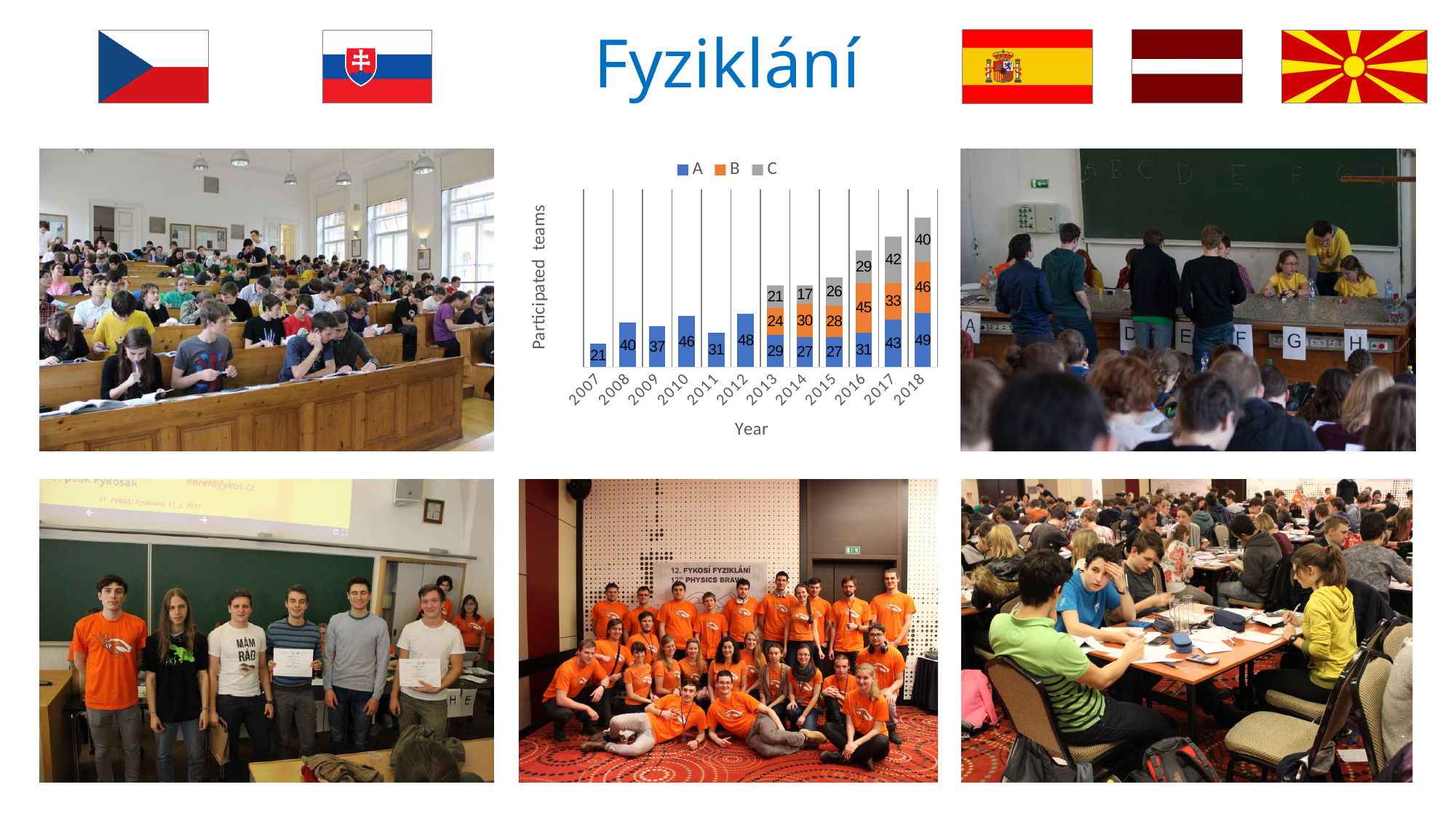
What is the total number of participated teams in 2018 (all series combined)? 135 How many years are shown on the x axis of the chart? 12 What is the value of series A in 2007? 21 What is the value of series B in 2016? 45 How many series does the chart legend list? 3 What is the label of the y axis of the chart? Participated teams What is the value of series C in 2018? 40 What is the difference between the series A values for 2018 and 2007? 28 Which year has the lowest value for series A? 2007 Which is larger: series B in 2017 or series C in 2017? series C in 2017 Which year has the highest value for series A? 2018 What kind of chart is shown on the slide? stacked bar chart